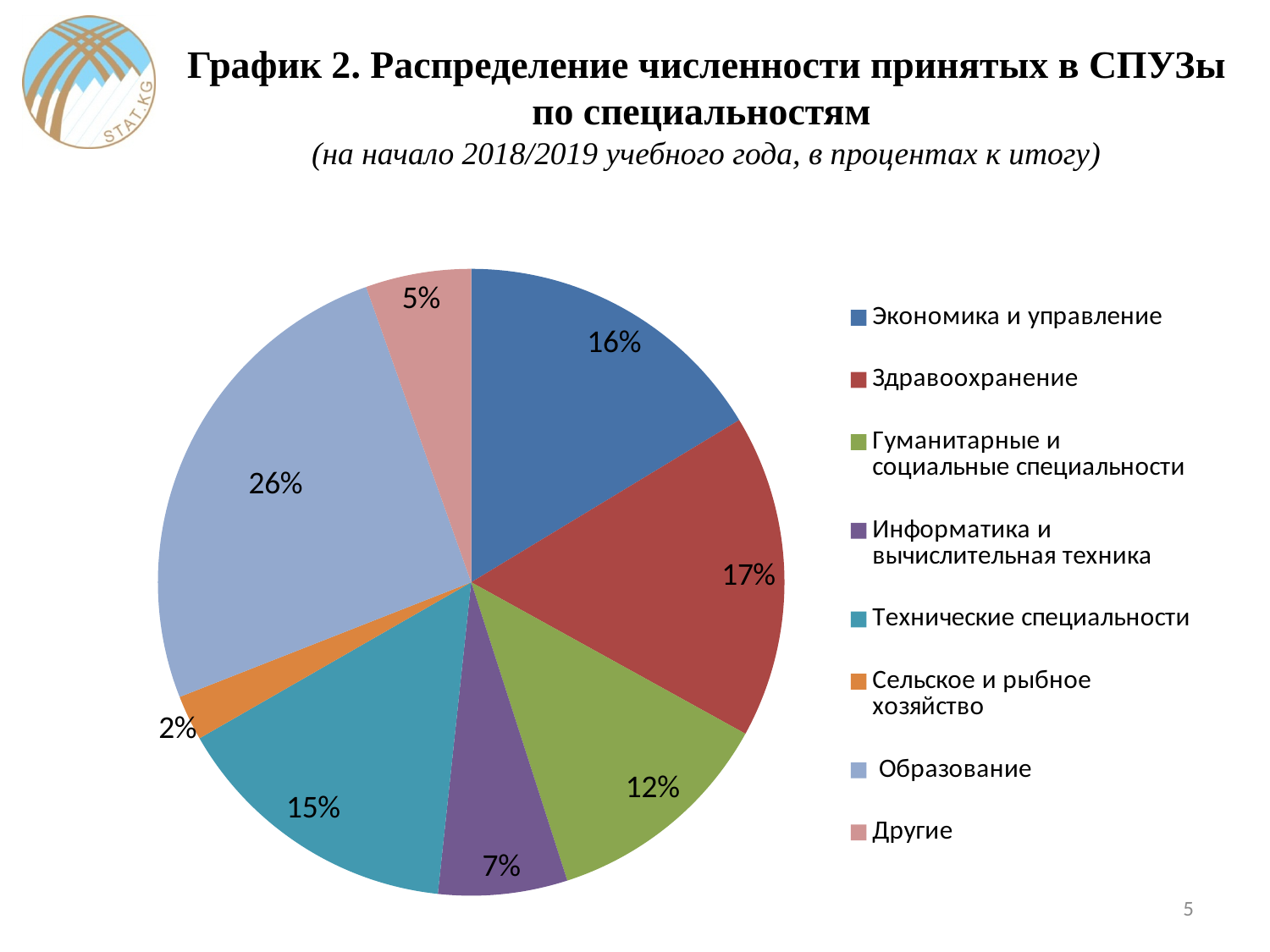
Which category has the largest share of the pie? Образование What colour is the slice for Здравоохранение? red What is the value for Здравоохранение? 17% What share of the pie does Образование have? 26% How many categories does the legend list? 8 What kind of chart is shown on the slide? pie chart What is the value for Технические специальности? 15% Which is larger, the share for Информатика и вычислительная техника or the share for Другие? Информатика и вычислительная техника What is the value for Сельское и рыбное хозяйство? 2% Which category has the smallest share of the pie? Сельское и рыбное хозяйство What is the difference between the shares of Образование and Гуманитарные и социальные специальности? 14% What is the value for Экономика и управление? 16%